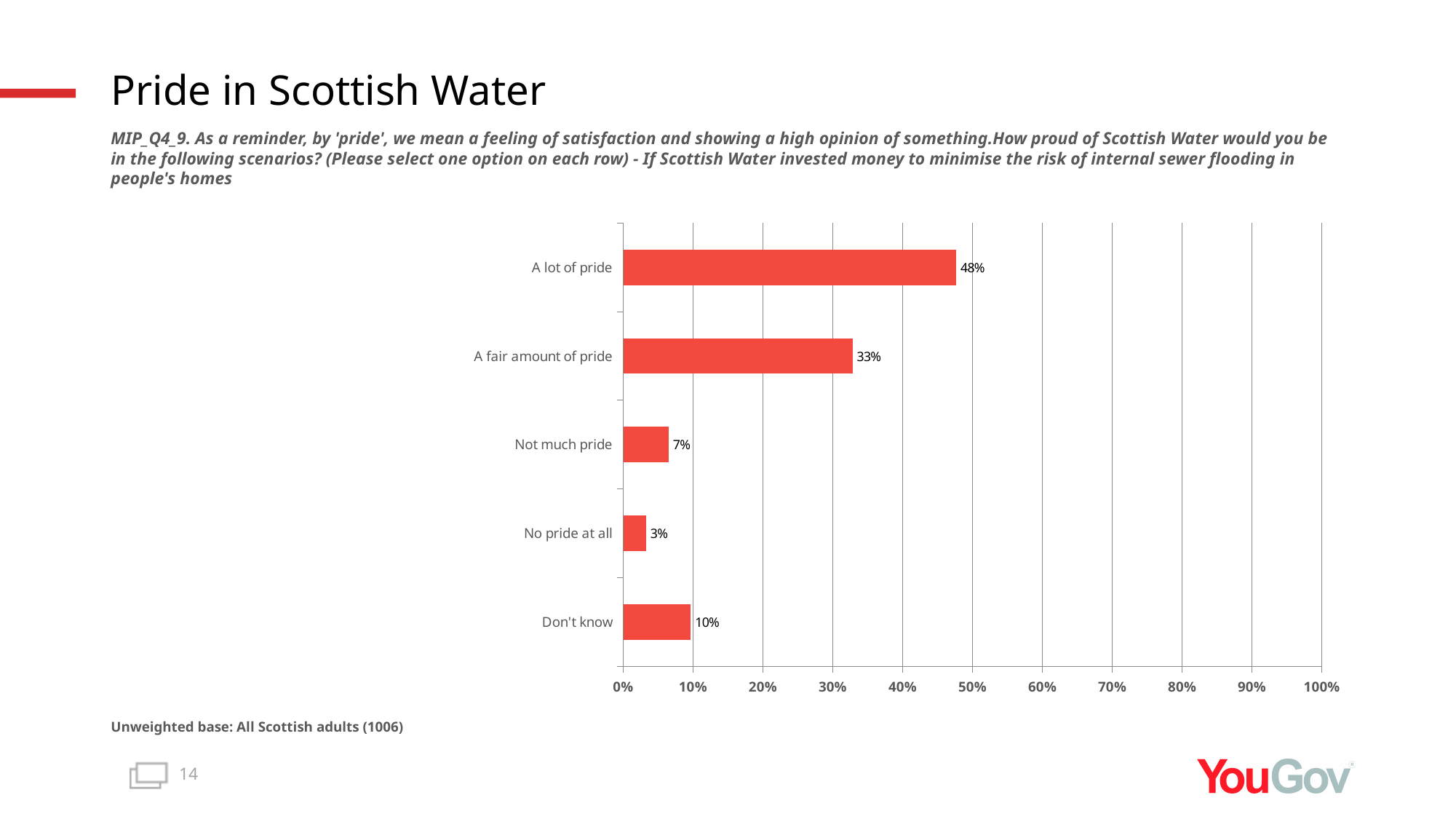
What is the value for 'No pride at all'? 3% How many categories are shown in the chart? 5 What percentage of respondents answered 'Don't know'? 10% What percentage of respondents said they would feel 'A lot of pride'? 48% What is the value shown for 'A fair amount of pride'? 33% What kind of chart is shown on the slide? Bar chart Is the value for 'A lot of pride' greater or less than 40%? greater What is the unweighted base stated below the chart? All Scottish adults (1006) What is the difference between 'A lot of pride' and 'A fair amount of pride'? 15% Which category has the highest value? A lot of pride Which category has the lowest value? No pride at all Which is larger: 'Not much pride' or 'Don't know'? Don't know